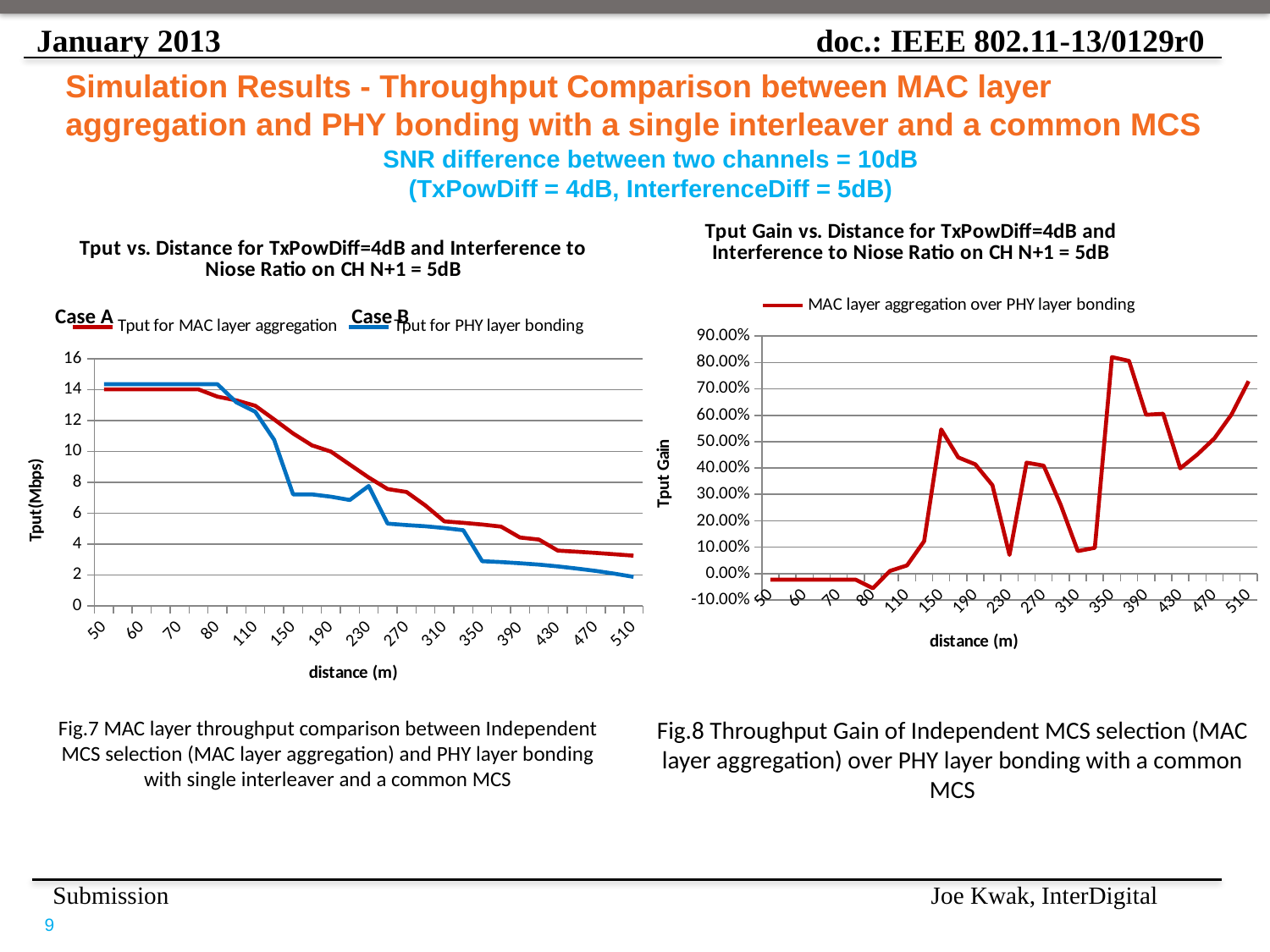
What kind of chart is the left chart titled 'Tput vs. Distance for TxPowDiff=4dB and Interference to Niose Ratio on CH N+1 = 5dB'? line chart How many series does the legend of the left chart (Tput vs. Distance) list? 2 In the left chart (Tput vs. Distance), is the value of Tput for PHY layer bonding at distance 150 greater or less than 8? less In the left chart (Tput vs. Distance), do the throughput values generally rise or fall as distance increases? fall What is the y-axis label of the right chart (Tput Gain vs. Distance)? Tput Gain In the left chart (Tput vs. Distance), is the value of Tput for PHY layer bonding at distance 510 greater or less than 4? less What kind of chart is the right chart titled 'Tput Gain vs. Distance for TxPowDiff=4dB and Interference to Niose Ratio on CH N+1 = 5dB'? line chart In the right chart (Tput Gain vs. Distance), is the gain at distance 230 greater or less than 10.00%? less In the left chart (Tput vs. Distance), at distance 150, which series has the larger value: Tput for MAC layer aggregation or Tput for PHY layer bonding? Tput for MAC layer aggregation How many series does the legend of the right chart (Tput Gain vs. Distance) list? 1